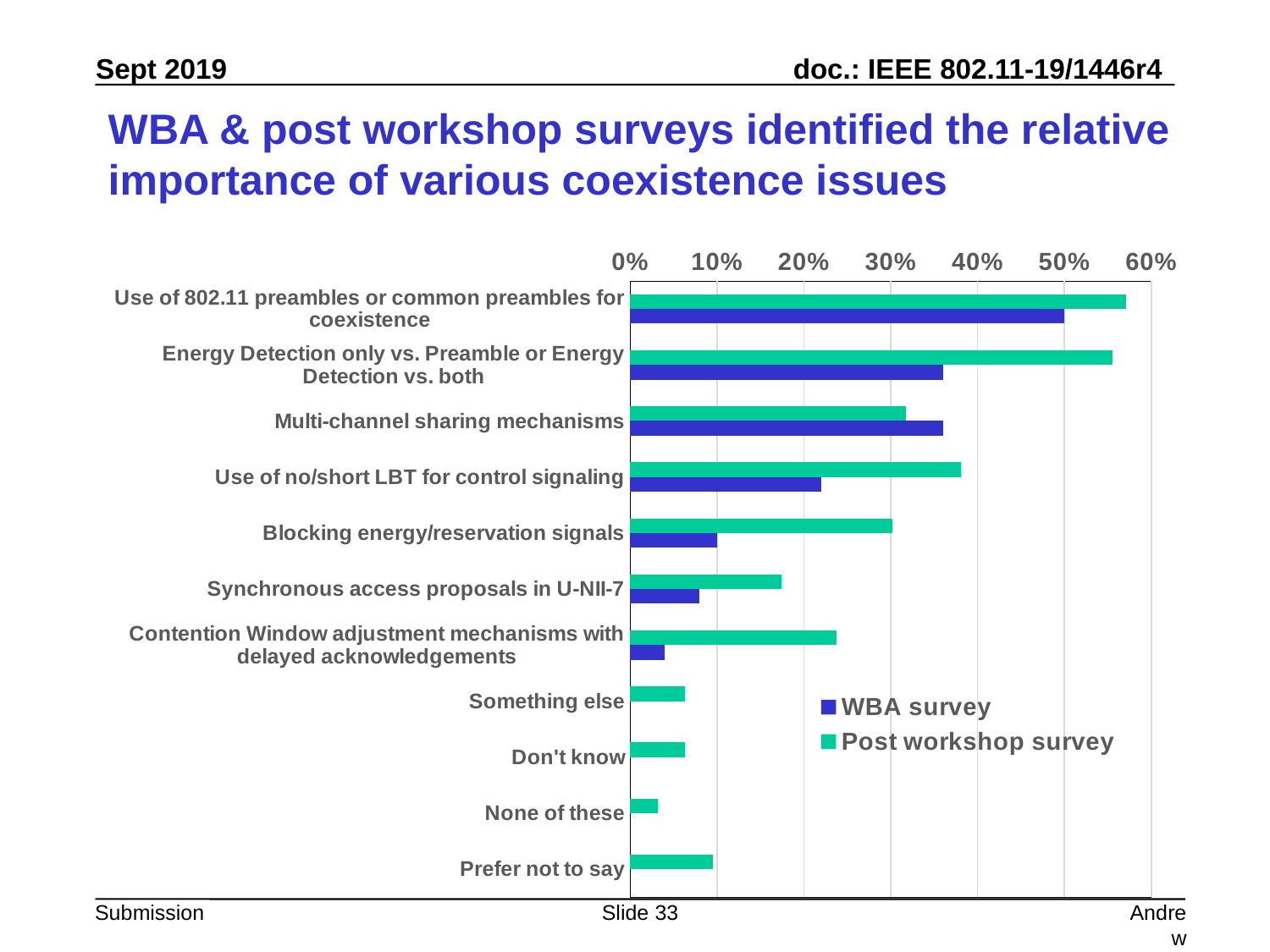
What colour represents the WBA survey series in the legend? Blue For Use of no/short LBT for control signaling, which series has the larger value, WBA survey or Post workshop survey? Post workshop survey Which category has the highest value for the WBA survey? Use of 802.11 preambles or common preambles for coexistence For Multi-channel sharing mechanisms, which series has the larger value, WBA survey or Post workshop survey? WBA survey Is the Post workshop survey value for Blocking energy/reservation signals greater or less than 20%? greater Which category has the lowest value for the Post workshop survey? None of these How many categories are plotted on the chart? 11 How many series does the legend list? 2 What kind of chart is shown on the slide? Bar chart Is the Post workshop survey value for Contention Window adjustment mechanisms with delayed acknowledgements greater or less than 20%? greater How many categories have a WBA survey bar plotted? 7 Is the WBA survey value for Blocking energy/reservation signals greater or less than 20%? less